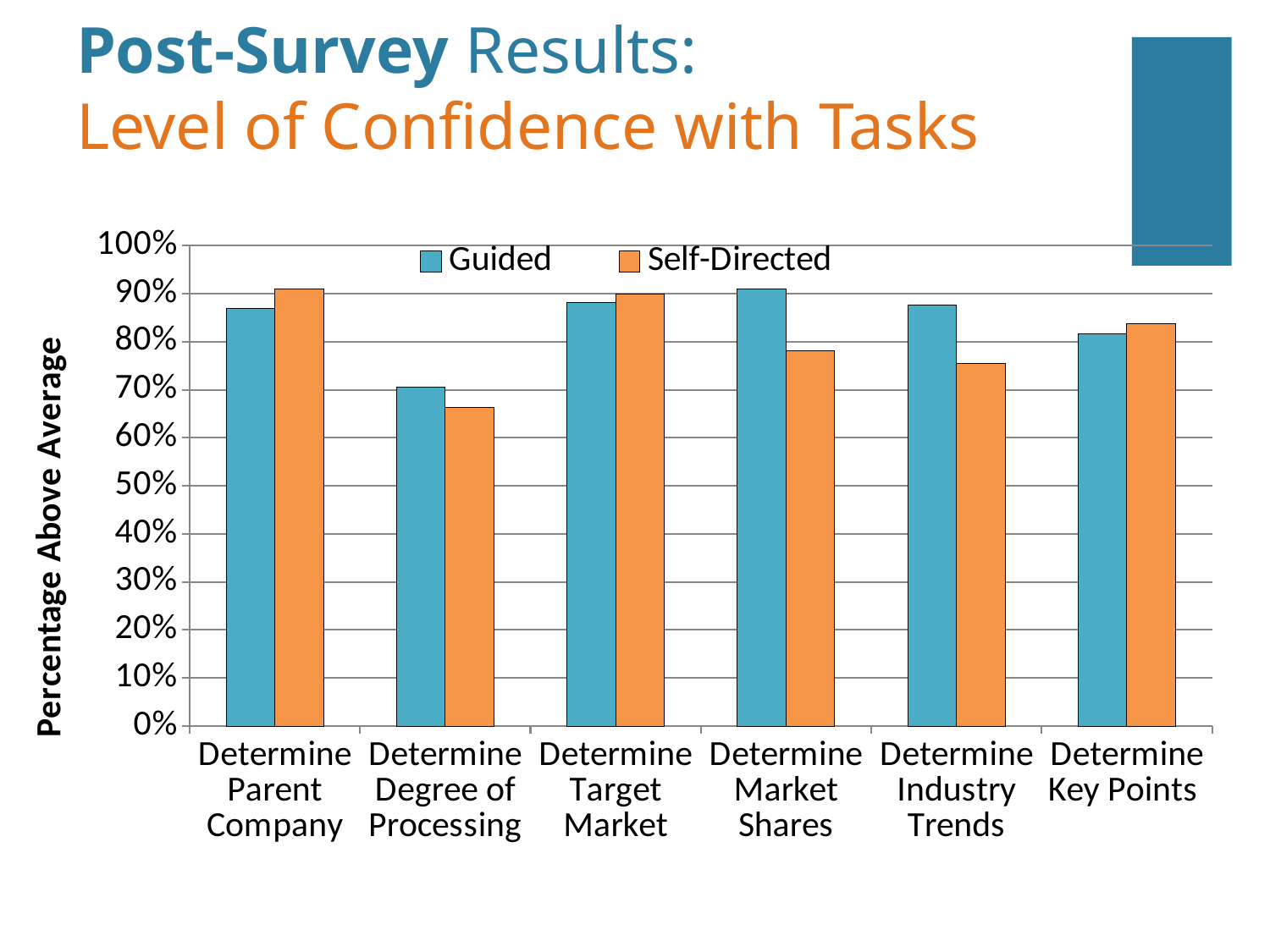
Which task has the highest Guided value? Determine Market Shares For Determine Parent Company, which is larger: Guided or Self-Directed? Self-Directed How many series does the legend list? 2 Is the Self-Directed value for Determine Degree of Processing greater or less than 70%? less How many task categories are shown on the x axis? 6 What kind of chart is shown on the slide? bar chart For Determine Industry Trends, which is larger: Guided or Self-Directed? Guided Is the Guided value for Determine Market Shares greater or less than 80%? greater For Determine Market Shares, which is larger: Guided or Self-Directed? Guided Which task has the lowest Guided value? Determine Degree of Processing What is the label of the y axis? Percentage Above Average Which task has the lowest Self-Directed value? Determine Degree of Processing